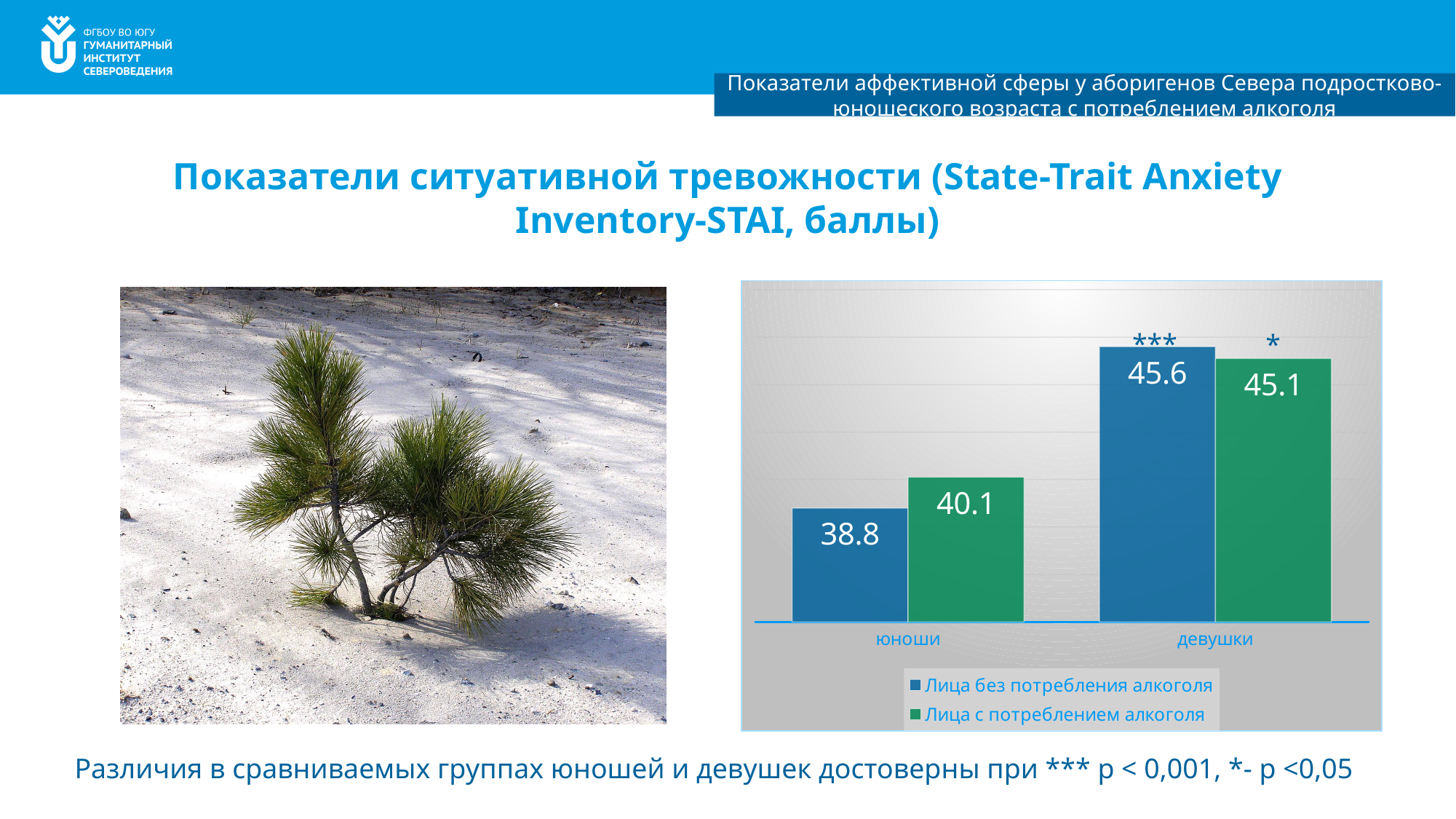
What value is shown for девушки in the series Лица без потребления алкоголя? 45.6 What value is shown for девушки in the series Лица с потреблением алкоголя? 45.1 Which bar has the highest value on the chart? девушки, Лица без потребления алкоголя (45.6) What is the difference between the value for девушки and the value for юноши in the series Лица без потребления алкоголя? 6.8 What kind of chart is shown on the slide? bar chart Which bar has the lowest value on the chart? юноши, Лица без потребления алкоголя (38.8) What value is shown for юноши in the series Лица с потреблением алкоголя? 40.1 What value is shown for юноши in the series Лица без потребления алкоголя? 38.8 What is the difference between the two series values for юноши? 1.3 How many categories are shown on the x axis of the chart? 2 How many series does the legend list? 2 For девушки, which series has the larger value: Лица без потребления алкоголя or Лица с потреблением алкоголя? Лица без потребления алкоголя